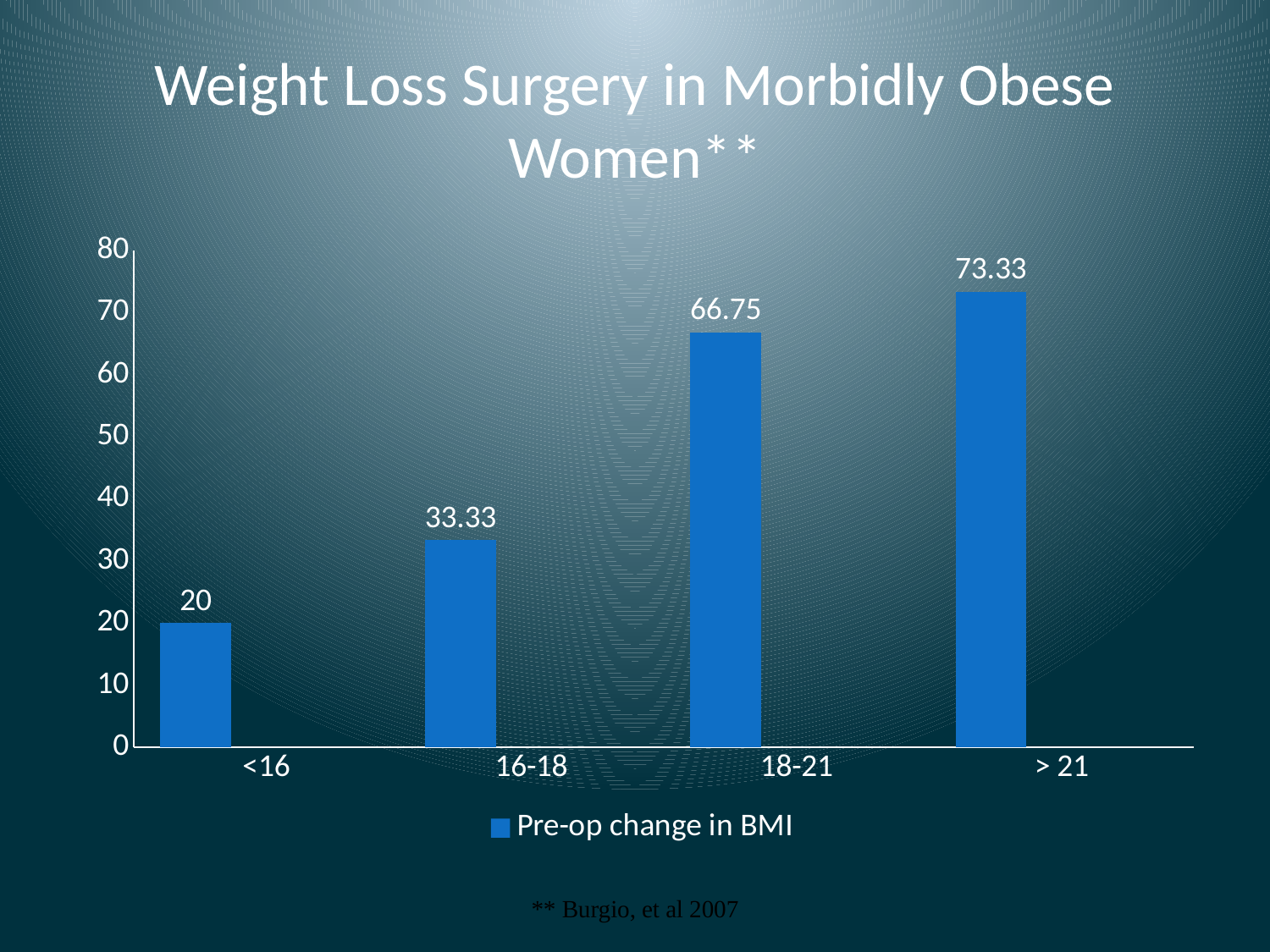
What is the value for the 16-18 category? 33.33 What is the value for the <16 category? 20 Do the values rise or fall from left to right along the x axis? rise How many series does the legend list? 1 What is the difference between the values for > 21 and 18-21? 6.58 Which category has the lowest value? <16 Which category has the highest value? > 21 What is the value for the 18-21 category? 66.75 What is the value for the > 21 category? 73.33 Which is larger, the value for 16-18 or the value for 18-21? 18-21 How many categories are shown on the x axis? 4 What kind of chart is shown on the slide? bar chart